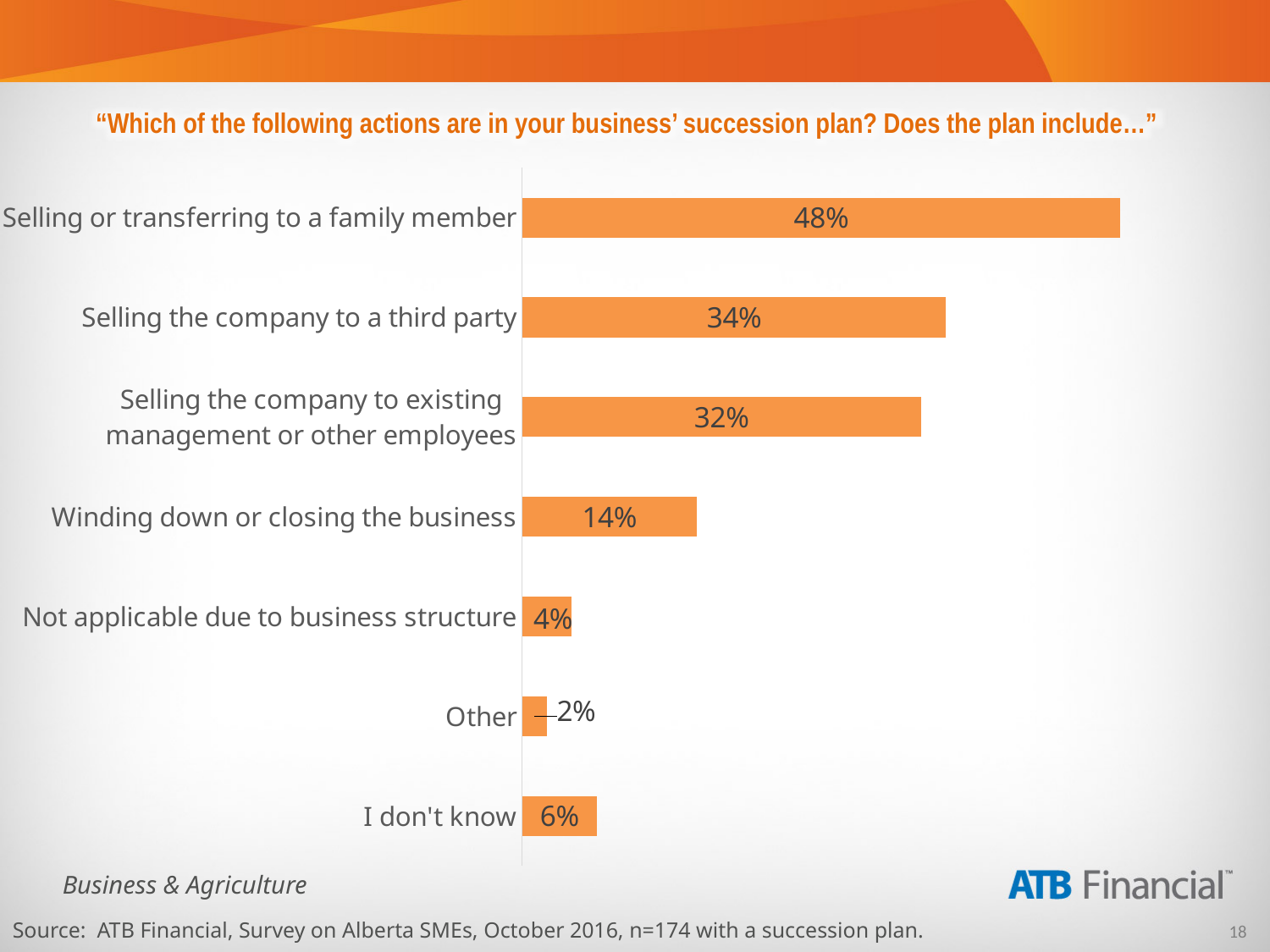
What percentage is shown for 'Winding down or closing the business'? 14% What percentage of respondents said their succession plan includes selling or transferring to a family member? 48% Which category has the highest value? Selling or transferring to a family member What is the value for 'I don't know'? 6% Which is larger: 'Not applicable due to business structure' or 'I don't know'? I don't know What is the difference between 'Selling the company to a third party' and 'Selling the company to existing management or other employees'? 2% What kind of chart is shown on the slide? Bar chart How many categories are shown in the chart? 7 What is the source of the survey data shown on the slide? ATB Financial, Survey on Alberta SMEs, October 2016 Which category has the lowest value? Other What is the difference between 'Selling or transferring to a family member' and 'Selling the company to a third party'? 14% What is the value for 'Selling the company to a third party'? 34%